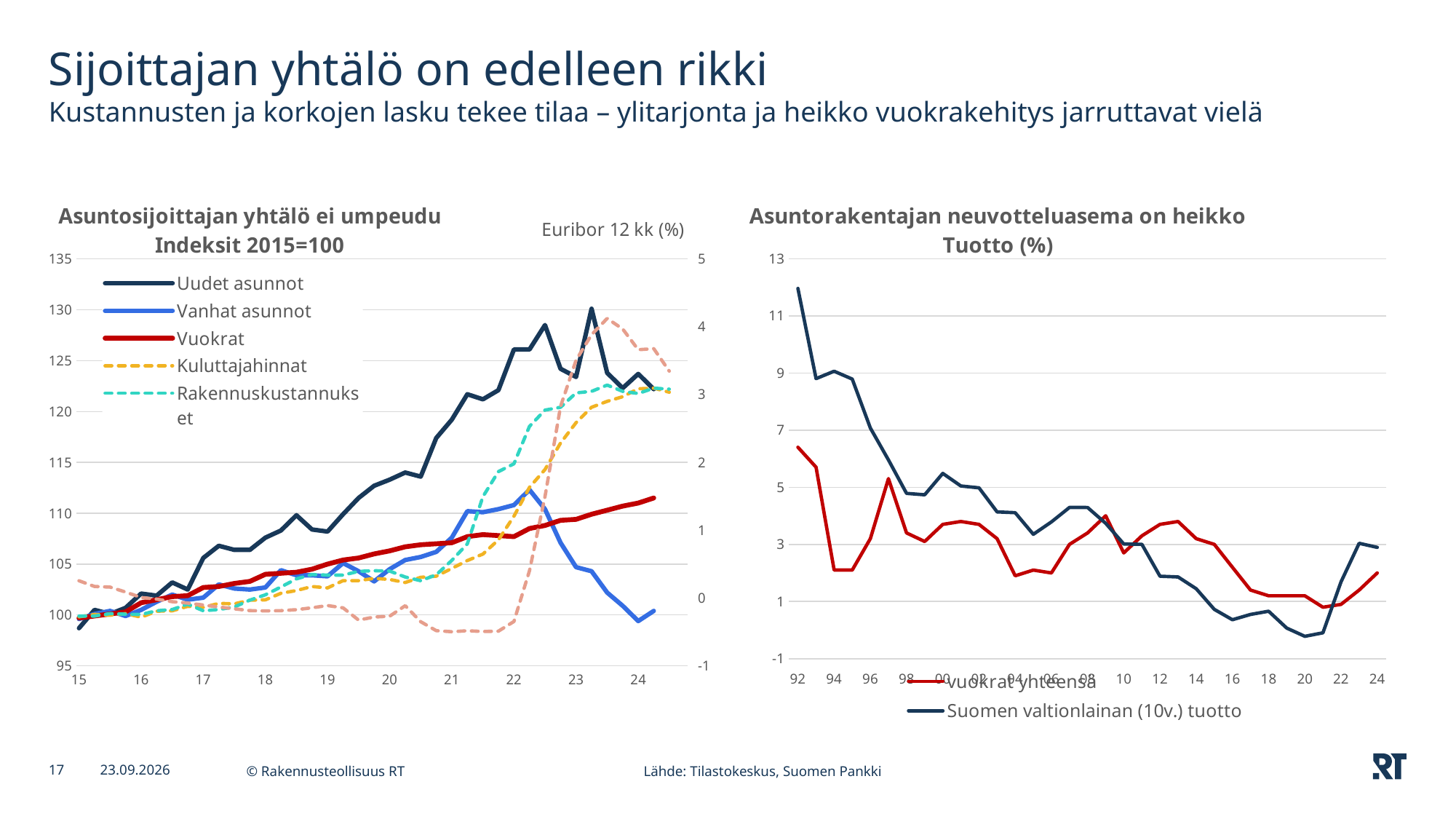
In the right chart 'Asuntorakentajan neuvotteluasema on heikko', does Suomen valtionlainan (10v.) tuotto generally rise or fall from 1992 to 2020? fall In the left chart 'Asuntosijoittajan yhtälö ei umpeudu', is the peak of the Euribor 12 kk (%) line greater or less than 3 on the right-hand axis? greater What kind of chart is the right chart titled 'Asuntorakentajan neuvotteluasema on heikko'? line chart In the left chart 'Asuntosijoittajan yhtälö ei umpeudu', what is the label of the secondary (right-hand) axis? Euribor 12 kk (%) How many series does the legend of the left chart 'Asuntosijoittajan yhtälö ei umpeudu' list? 5 What kind of chart is the left chart titled 'Asuntosijoittajan yhtälö ei umpeudu'? line chart In the right chart 'Asuntorakentajan neuvotteluasema on heikko', is the value of Vuokrat yhteensä in 1992 greater or less than 5? greater In the left chart 'Asuntosijoittajan yhtälö ei umpeudu', is the value of Vuokrat at the end of the series (2024) greater or less than 110? greater How many series does the legend of the right chart 'Asuntorakentajan neuvotteluasema on heikko' list? 2